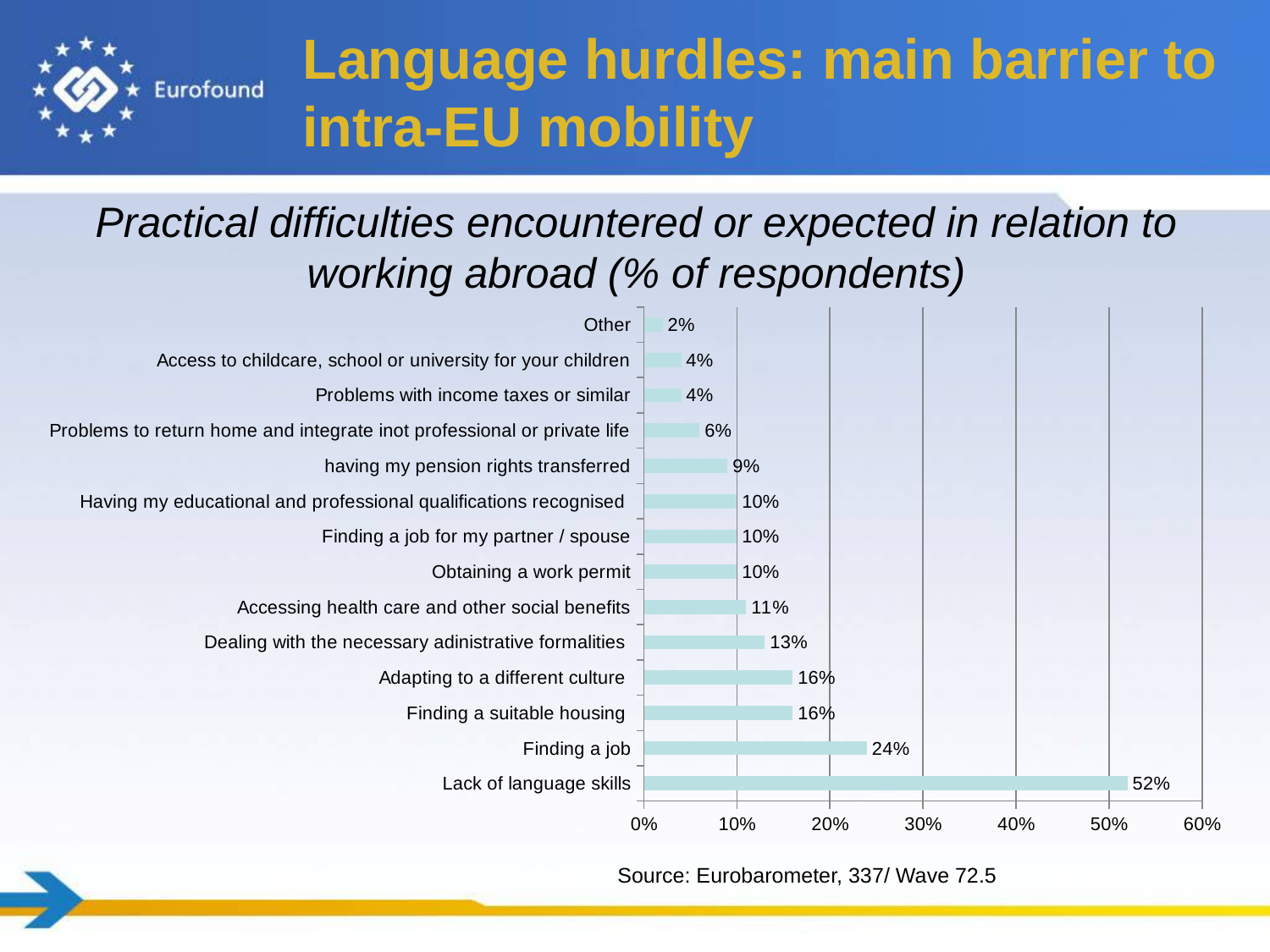
What is the value for having my pension rights transferred? 9% Is the value for Finding a job greater or less than 20%? greater How many categories are shown in the chart? 14 What is the difference between the values for Lack of language skills and Finding a job? 28% Which category has the highest value? Lack of language skills What is the value for Lack of language skills? 52% What is the source cited below the chart? Eurobarometer, 337/ Wave 72.5 What is the value for Dealing with the necessary adinistrative formalities? 13% What is the value for Finding a job? 24% Which is larger, the value for Accessing health care and other social benefits or the value for Obtaining a work permit? Accessing health care and other social benefits What kind of chart is shown on the slide? bar chart Which category has the lowest value? Other